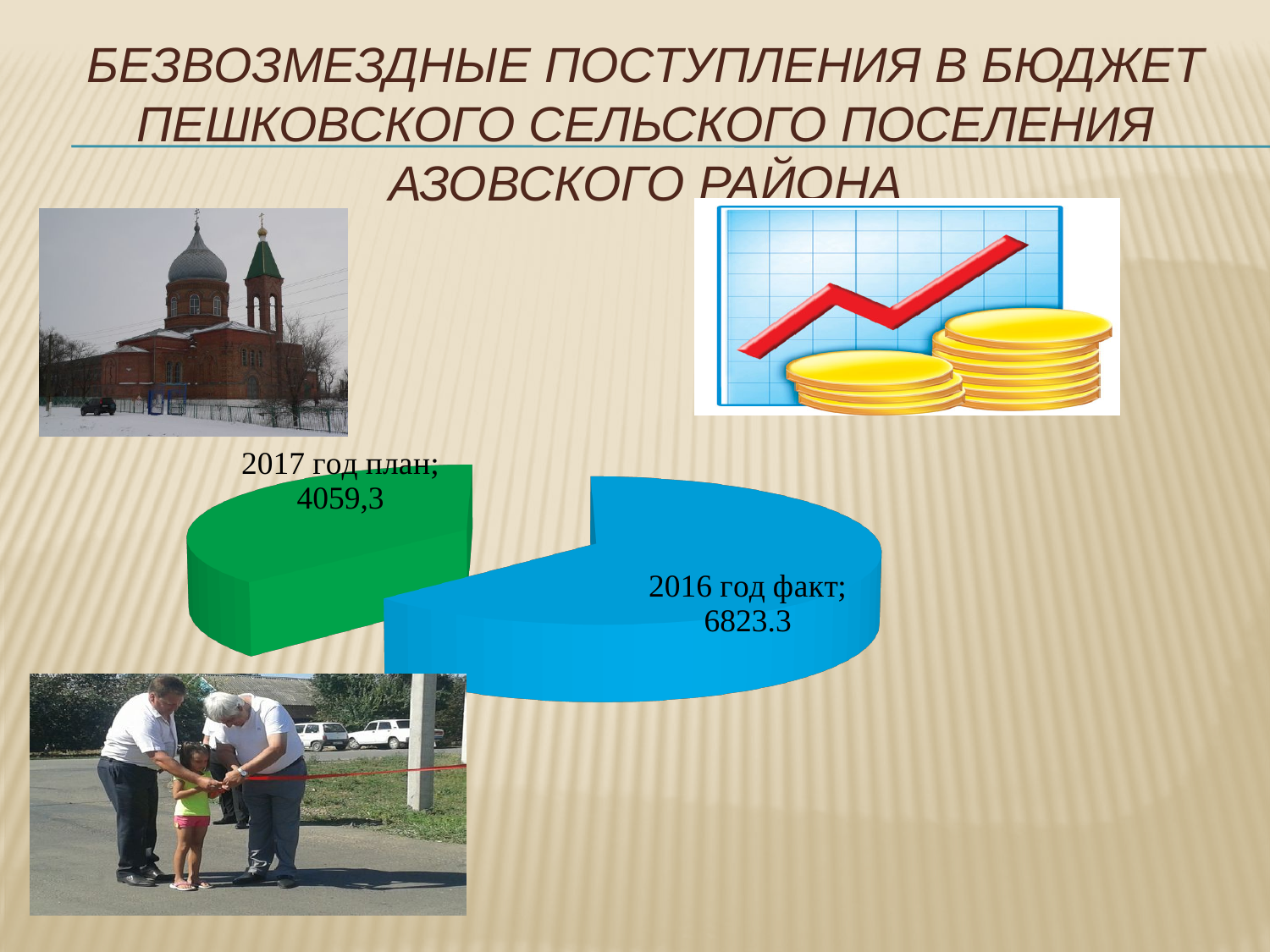
What is the difference between the "2016 год факт" value and the "2017 год план" value in the pie chart? 2764.0 What colour is the "2016 год факт" slice of the pie chart? Blue How many slices does the pie chart have? 2 What is the value shown for "2017 год план" in the pie chart? 4059,3 What is the total of the two values shown in the pie chart? 10882.6 What is the value shown for "2016 год факт" in the pie chart? 6823.3 Which slice of the pie chart has the largest value? 2016 год факт What colour is the "2017 год план" slice of the pie chart? Green Which is larger in the pie chart: the value for "2016 год факт" or the value for "2017 год план"? 2016 год факт What kind of chart is shown on the slide? Pie chart Which slice of the pie chart has the smallest value? 2017 год план